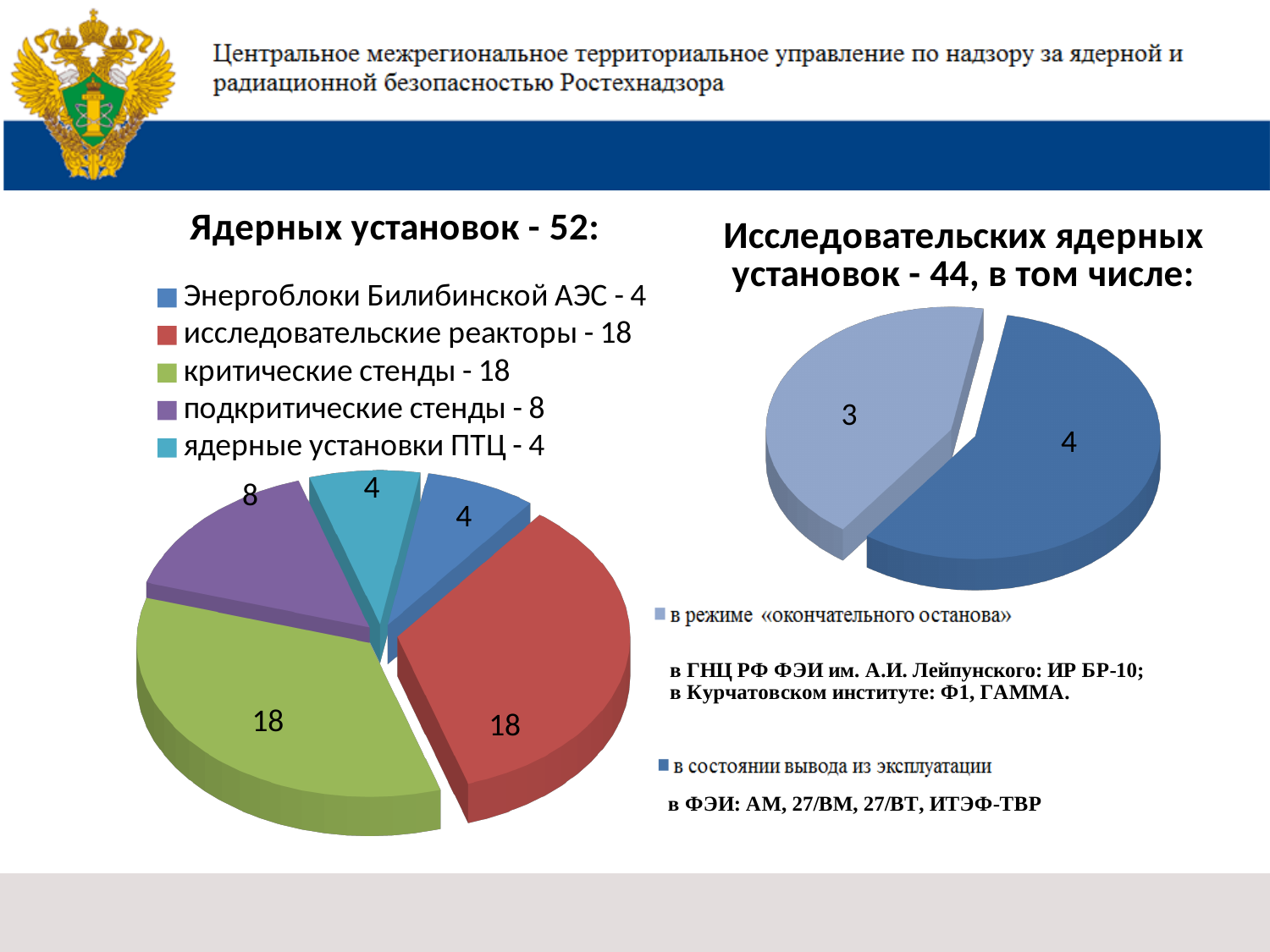
On the left chart titled "Ядерных установок - 52:", what kind of chart is shown? pie chart On the right chart titled "Исследовательских ядерных установок - 44, в том числе:", which category has the largest slice? в состоянии вывода из эксплуатации On the left chart titled "Ядерных установок - 52:", what is the value for "подкритические стенды"? 8 On the right chart titled "Исследовательских ядерных установок - 44, в том числе:", what is the value for "в состоянии вывода из эксплуатации"? 4 On the left chart titled "Ядерных установок - 52:", what is the value for "исследовательские реакторы"? 18 On the left chart titled "Ядерных установок - 52:", how many entries does the legend list? 5 On the right chart titled "Исследовательских ядерных установок - 44, в том числе:", what is the value for "в режиме «окончательного останова»"? 3 On the left chart titled "Ядерных установок - 52:", how many slices does the pie have? 5 On the left chart titled "Ядерных установок - 52:", which is larger: "подкритические стенды" or "Энергоблоки Билибинской АЭС"? подкритические стенды On the left chart titled "Ядерных установок - 52:", what is the difference between "критические стенды" and "подкритические стенды"? 10 On the right chart titled "Исследовательских ядерных установок - 44, в том числе:", how many slices does the pie have? 2 On the left chart titled "Ядерных установок - 52:", what is the value for "ядерные установки ПТЦ"? 4